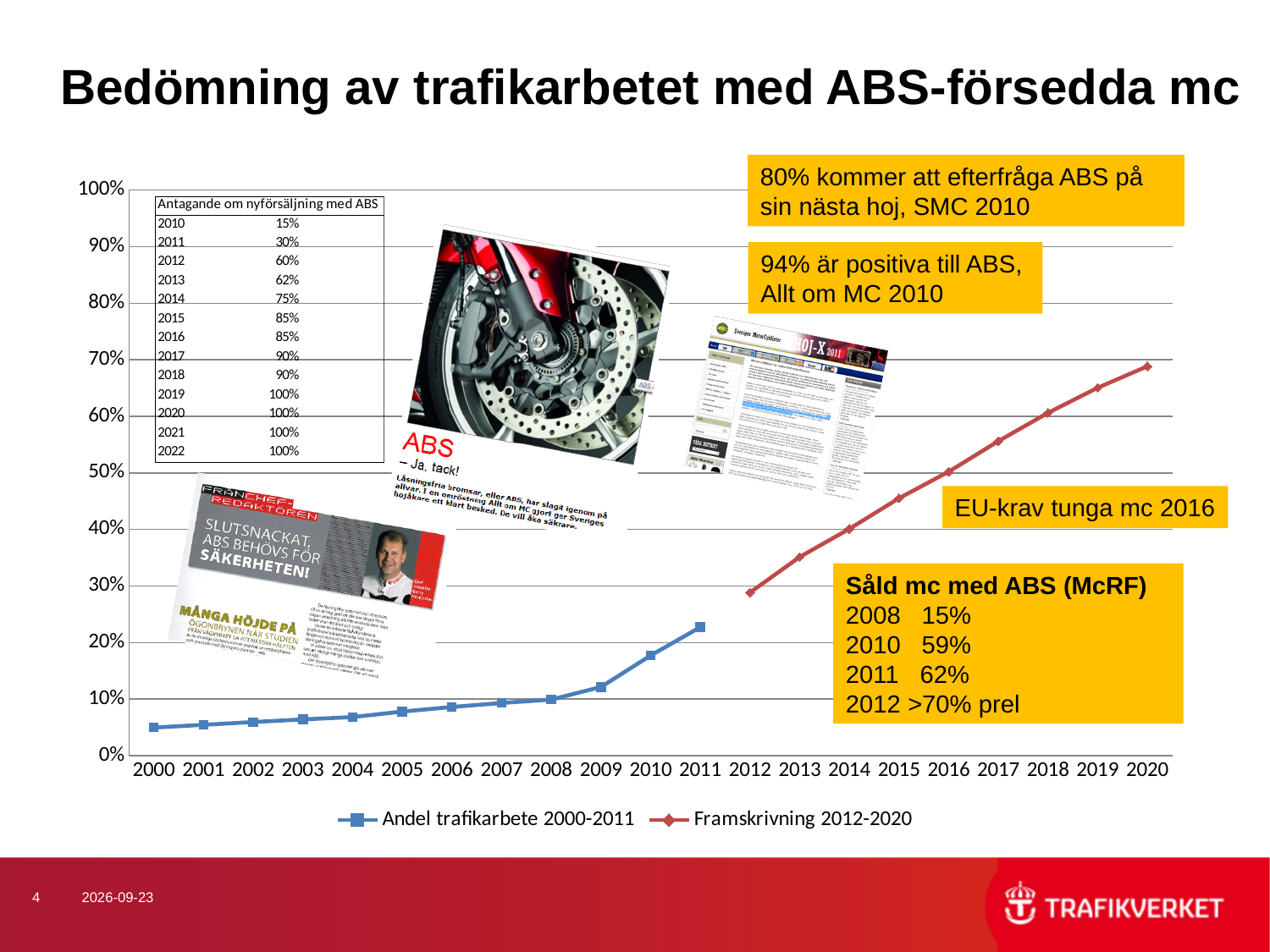
What kind of chart is shown on the slide? line chart How many years are labelled along the x axis of the chart? 21 What colour is the line for the series Framskrivning 2012-2020? red Which year has the lowest plotted value in the chart? 2000 Is the value for 2011 in the series Andel trafikarbete 2000-2011 greater or less than 20%? greater Is the value for 2000 in the series Andel trafikarbete 2000-2011 greater or less than 10%? less How many series does the chart legend list? 2 Which year has the highest plotted value in the chart? 2020 What are the two series named in the chart legend? Andel trafikarbete 2000-2011 and Framskrivning 2012-2020 Which is larger, the plotted value for 2005 or the plotted value for 2011? 2011 Do the plotted values rise or fall from 2000 to 2020? rise